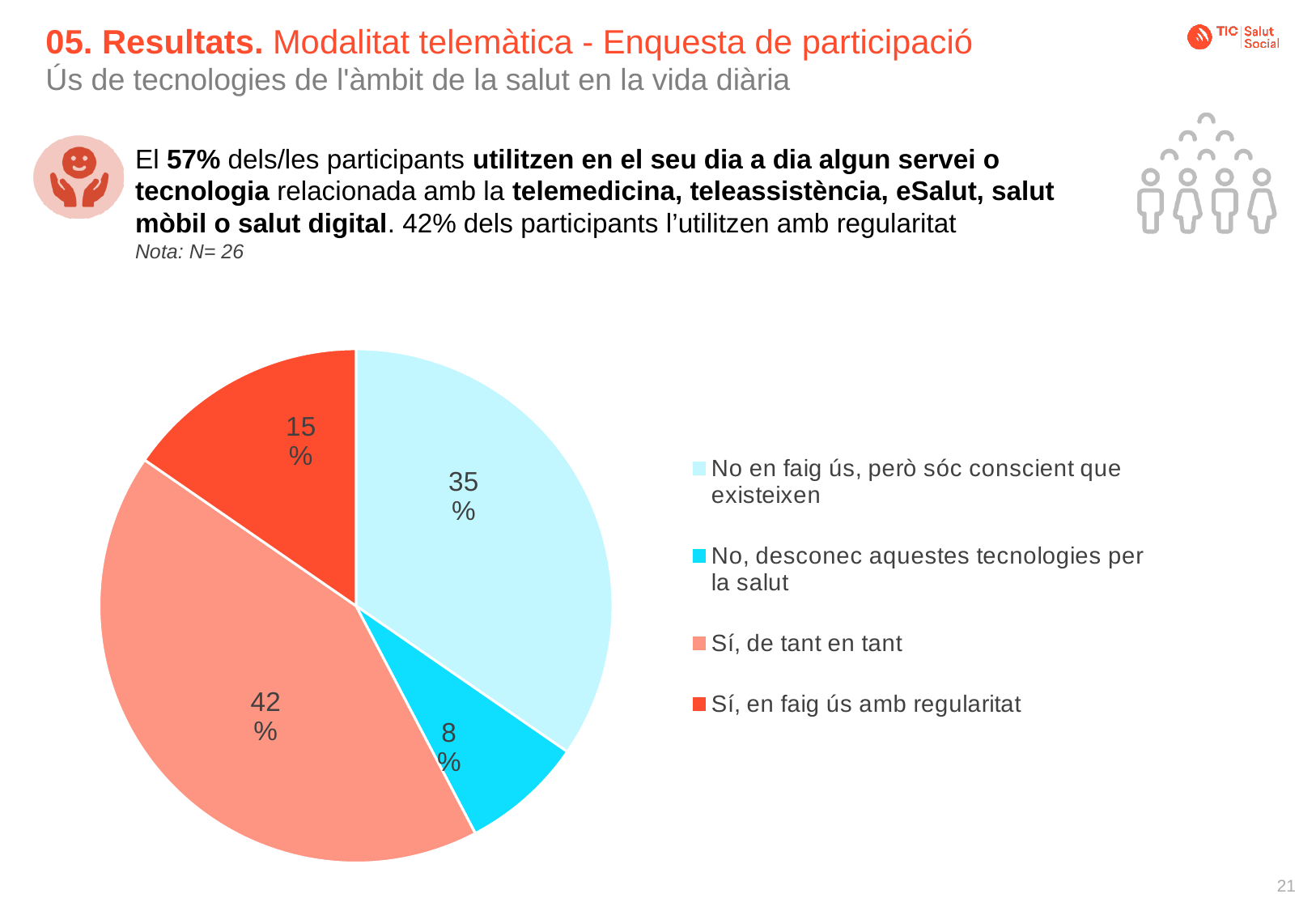
What share of the pie is 'Sí, de tant en tant'? 42% How many entries does the legend list? 4 How many slices does the pie chart have? 4 What kind of chart is shown on the slide? Pie chart What share of the pie is 'Sí, en faig ús amb regularitat'? 15% Which is larger: the slice for 'No en faig ús, però sóc conscient que existeixen' or the slice for 'Sí, en faig ús amb regularitat'? No en faig ús, però sóc conscient que existeixen What is the difference in percentage points between 'Sí, de tant en tant' and 'Sí, en faig ús amb regularitat'? 27 What share of the pie is 'No, desconec aquestes tecnologies per la salut'? 8% Which category has the smallest slice of the pie? No, desconec aquestes tecnologies per la salut Which category has the largest slice of the pie? Sí, de tant en tant What colour is the slice for 'Sí, en faig ús amb regularitat'? Red